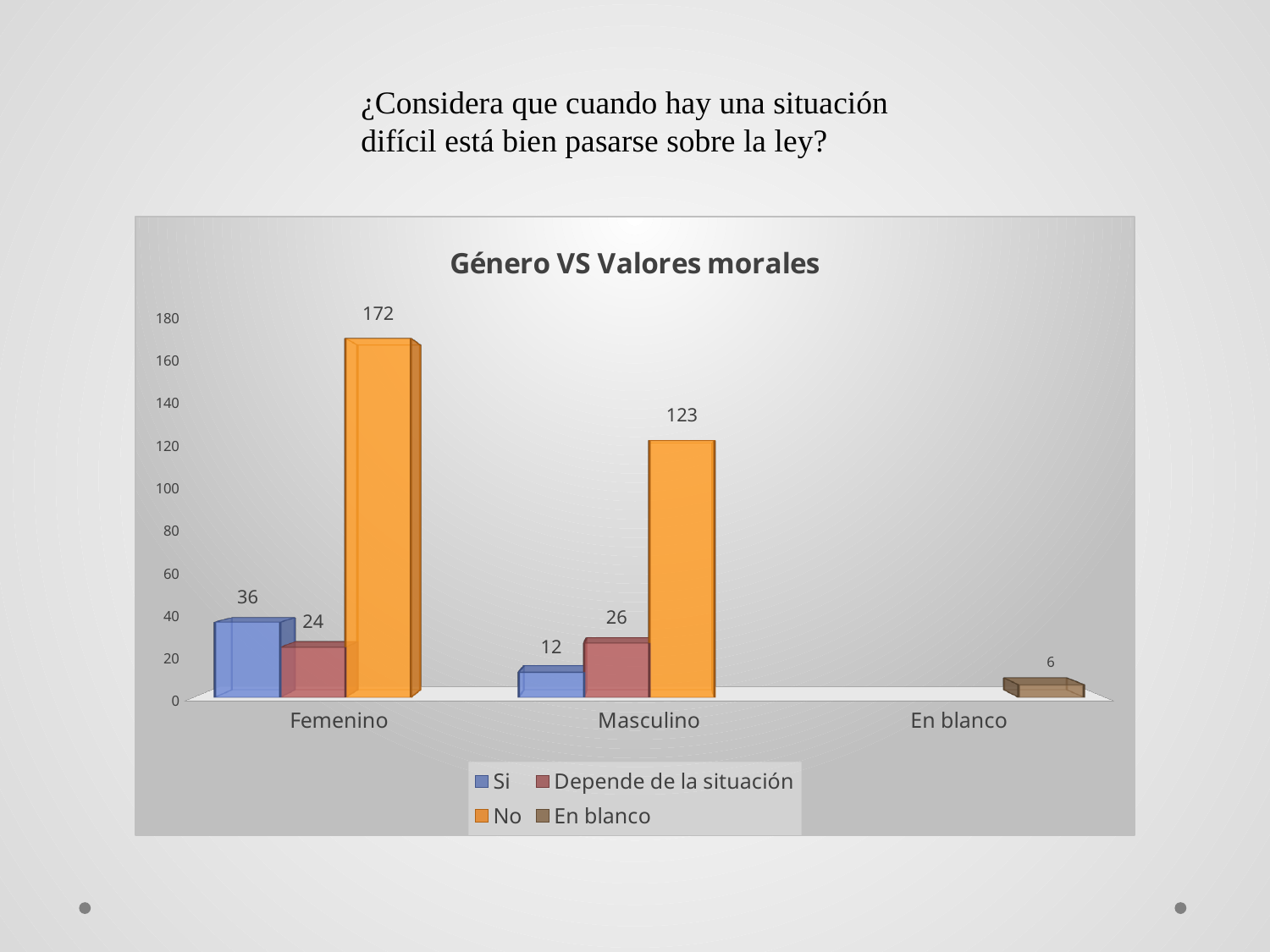
Which is larger: the "Si" value for Femenino or the "Si" value for Masculino? Femenino How many series does the legend list? 4 Which series has the lowest value in the Femenino category? Depende de la situación What is the value for "No" in the Femenino category? 172 What is the difference between the "No" values for Femenino and Masculino? 49 What is the title of the chart? Género VS Valores morales How many categories are shown on the x axis? 3 What kind of chart is shown on the slide? Bar chart What is the value for "Depende de la situación" in the Femenino category? 24 What is the value for "En blanco" in the En blanco category? 6 Which series has the highest value in the Masculino category? No What is the value for "Si" in the Masculino category? 12